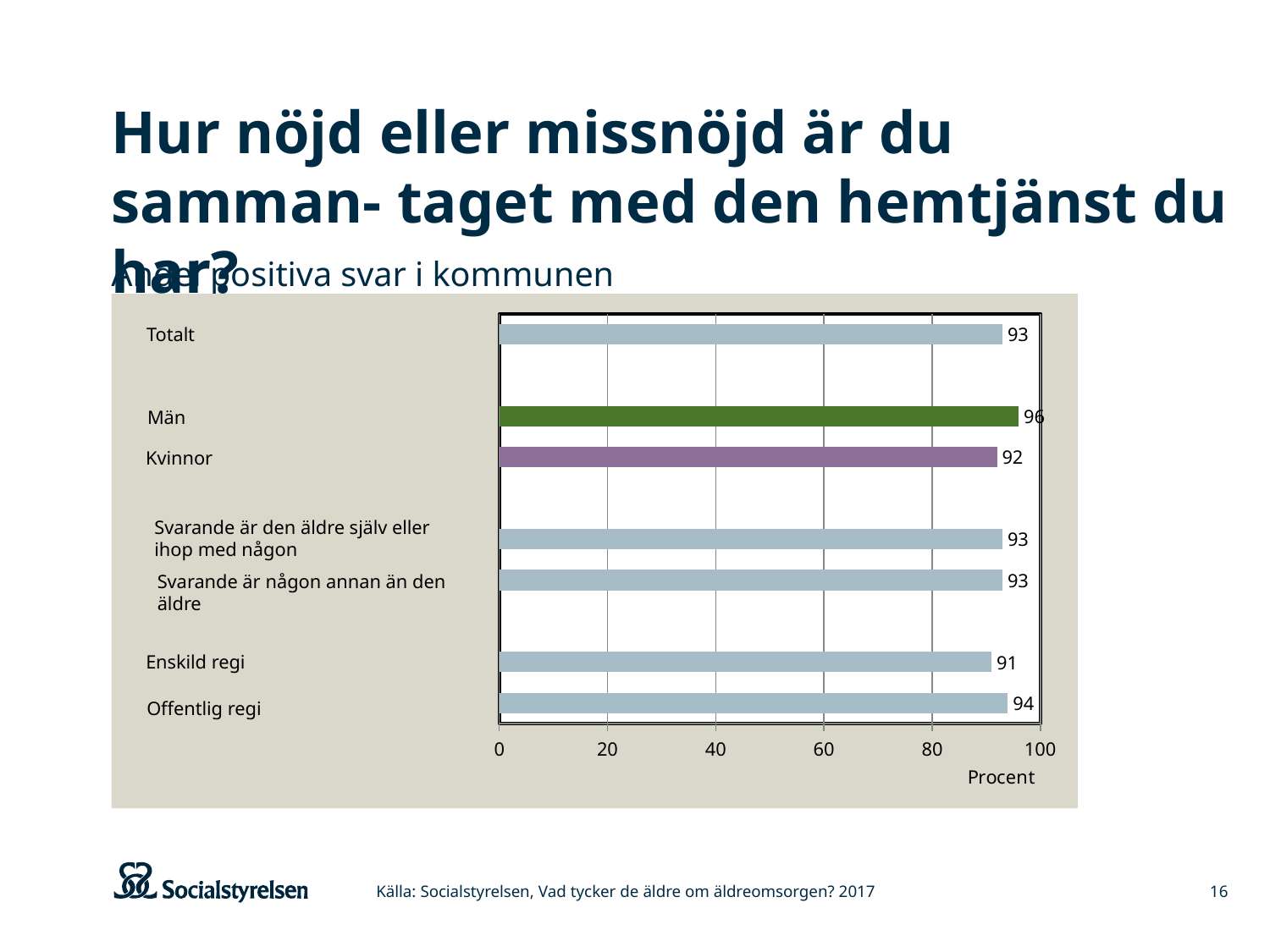
How many categories are shown in the chart? 7 What is the value for Totalt? 93 What is the value for Offentlig regi? 94 Which category has the highest value? Män What kind of chart is shown on the slide? Bar chart What is the label of the x axis? Procent Which is larger, the value for Offentlig regi or the value for Enskild regi? Offentlig regi What is the value for Kvinnor? 92 Which category has the lowest value? Enskild regi What is the value for Enskild regi? 91 What is the value for Män? 96 What is the difference between the values for Män and Kvinnor? 4